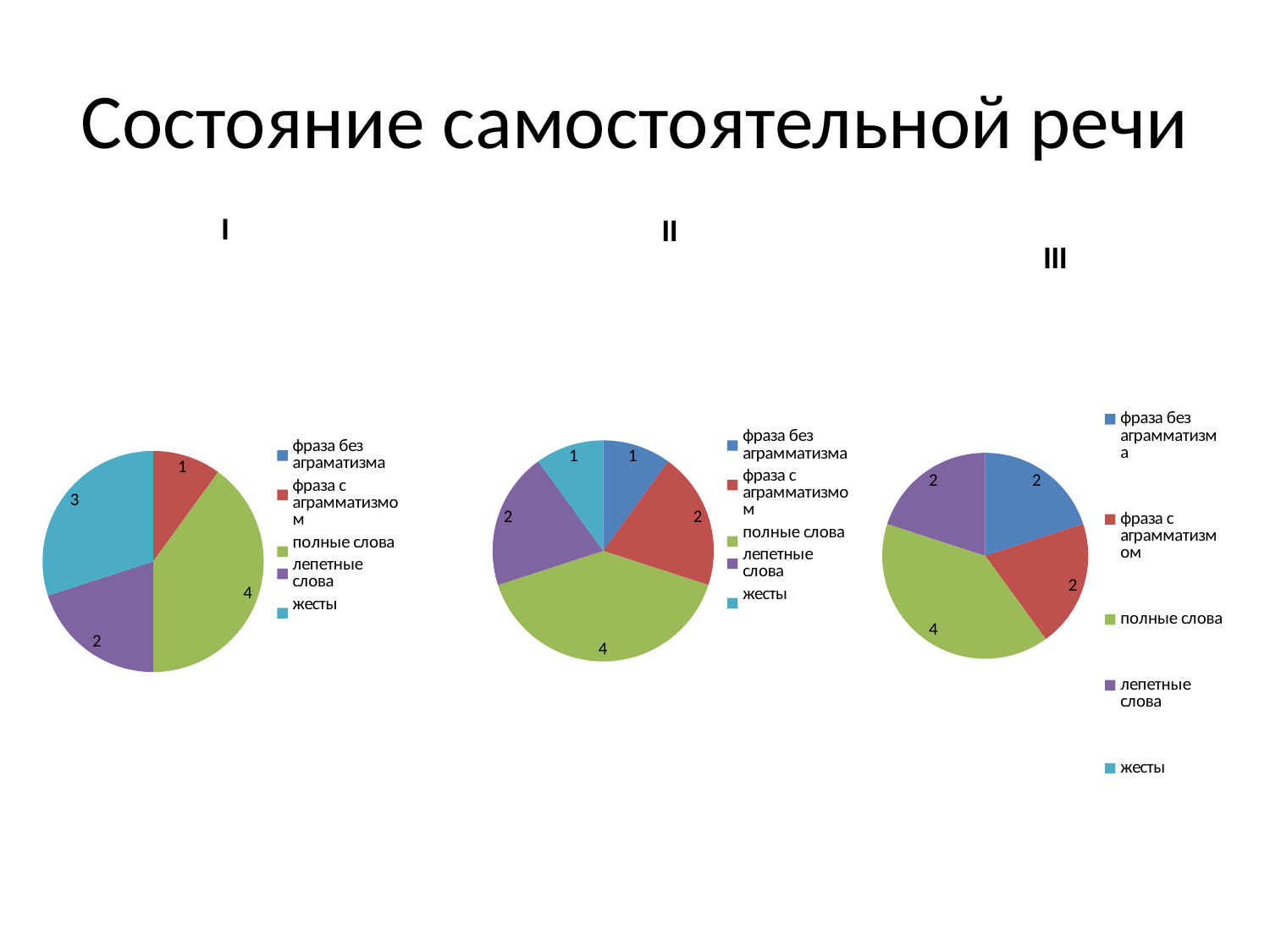
In chart II, which is larger: the value for фраза без аграмматизма or the value for лепетные слова? лепетные слова In chart II, which category has the largest slice? полные слова How many slices are shown in chart III? 4 In chart I, what is the value for полные слова? 4 In chart III, what is the value for полные слова? 4 In chart I, what is the difference between the values for полные слова and лепетные слова? 2 How many entries does the legend of chart III list? 5 In chart II, what share of the pie does полные слова represent? 40% In chart II, what is the value for фраза с аграмматизмом? 2 In chart I, what is the value for жесты? 3 What type of chart is used on this slide? pie chart In chart I, which labelled category has the smallest slice? фраза с аграмматизмом